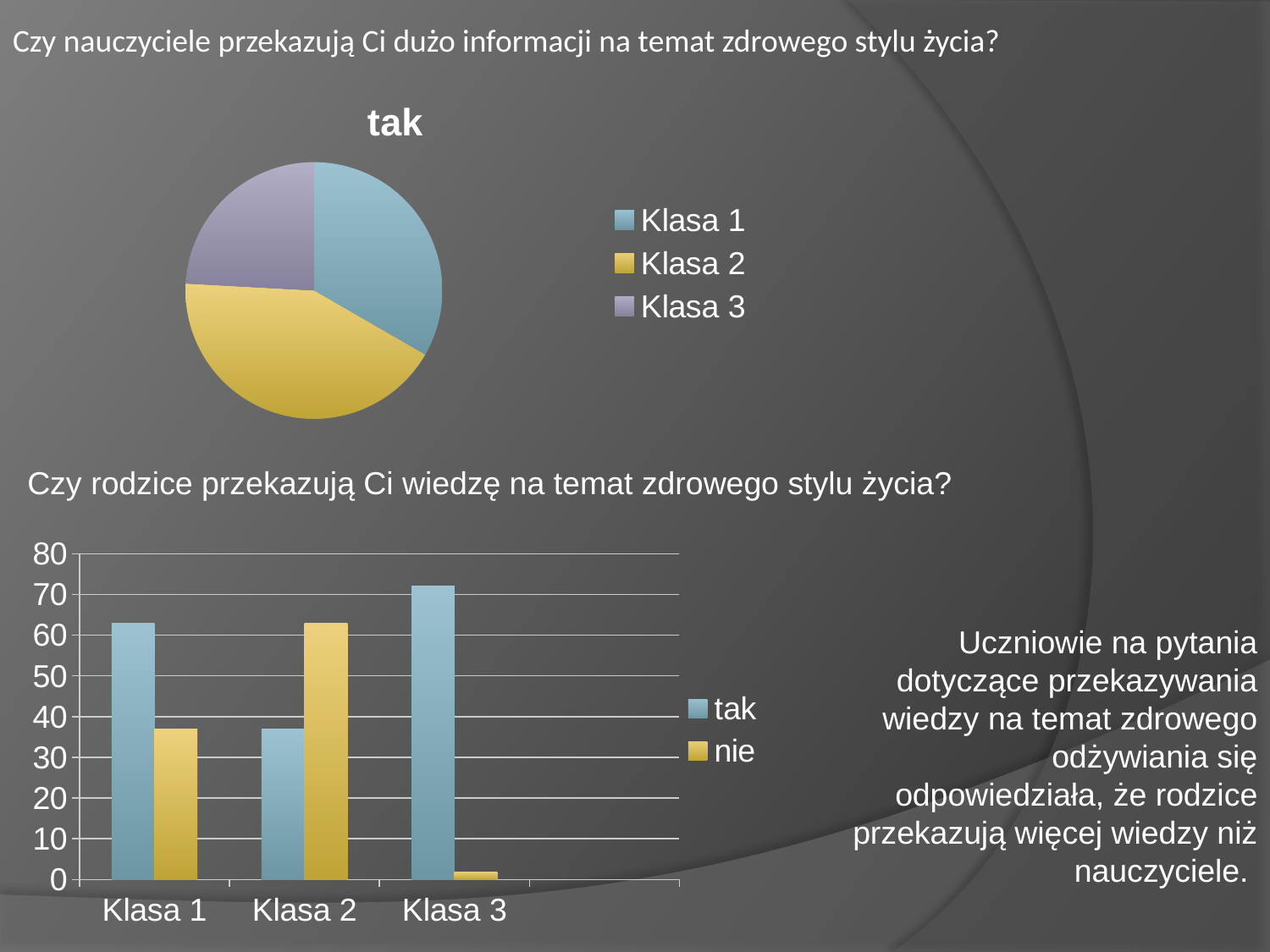
In the pie chart titled "tak", how many classes does the legend list? 3 In the pie chart titled "tak", which class has the largest slice? Klasa 2 In the bottom bar chart, is the "tak" value for Klasa 3 greater or less than 60? greater What kind of chart is the bottom chart on the slide? bar chart What kind of chart is the top chart titled "tak"? pie chart In the bottom bar chart, which class has the highest "tak" value? Klasa 3 In the pie chart titled "tak", which class has the smallest slice? Klasa 3 What is the title of the pie chart at the top of the slide? tak In the bottom bar chart, is the "nie" value for Klasa 3 greater or less than 10? less In the bottom bar chart, how many classes are shown on the x axis? 3 In the bottom bar chart, which is larger for Klasa 2: "tak" or "nie"? nie In the bottom bar chart, how many series does the legend list? 2